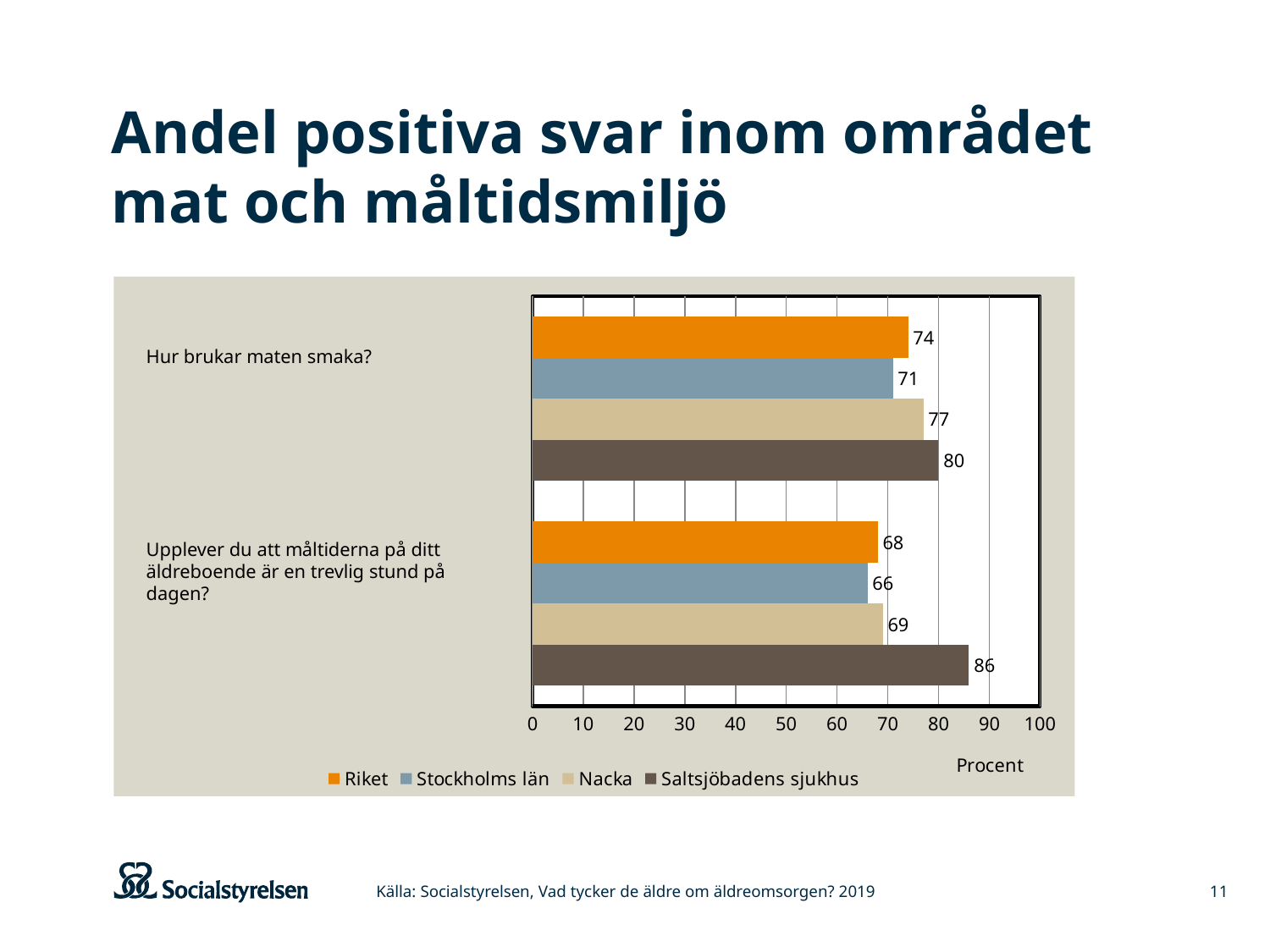
What value is shown for Saltsjöbadens sjukhus on the question "Hur brukar maten smaka?"? 80 What value is shown for Riket on the question "Upplever du att måltiderna på ditt äldreboende är en trevlig stund på dagen?"? 68 How many series does the legend list? 4 Is the value for Saltsjöbadens sjukhus on "Upplever du att måltiderna på ditt äldreboende är en trevlig stund på dagen?" greater or less than 80? greater Which series has the highest value for "Upplever du att måltiderna på ditt äldreboende är en trevlig stund på dagen?"? Saltsjöbadens sjukhus Which series has the lowest value for "Hur brukar maten smaka?"? Stockholms län What value is shown for Stockholms län on the question "Hur brukar maten smaka?"? 71 What is the difference between Saltsjöbadens sjukhus and Nacka on "Upplever du att måltiderna på ditt äldreboende är en trevlig stund på dagen?"? 17 Which is larger for Nacka: the value for "Hur brukar maten smaka?" or for "Upplever du att måltiderna på ditt äldreboende är en trevlig stund på dagen?"? Hur brukar maten smaka? What is the difference between Nacka and Riket on "Hur brukar maten smaka?"? 3 What kind of chart is shown on the slide? Bar chart What is the label on the horizontal axis of the chart? Procent